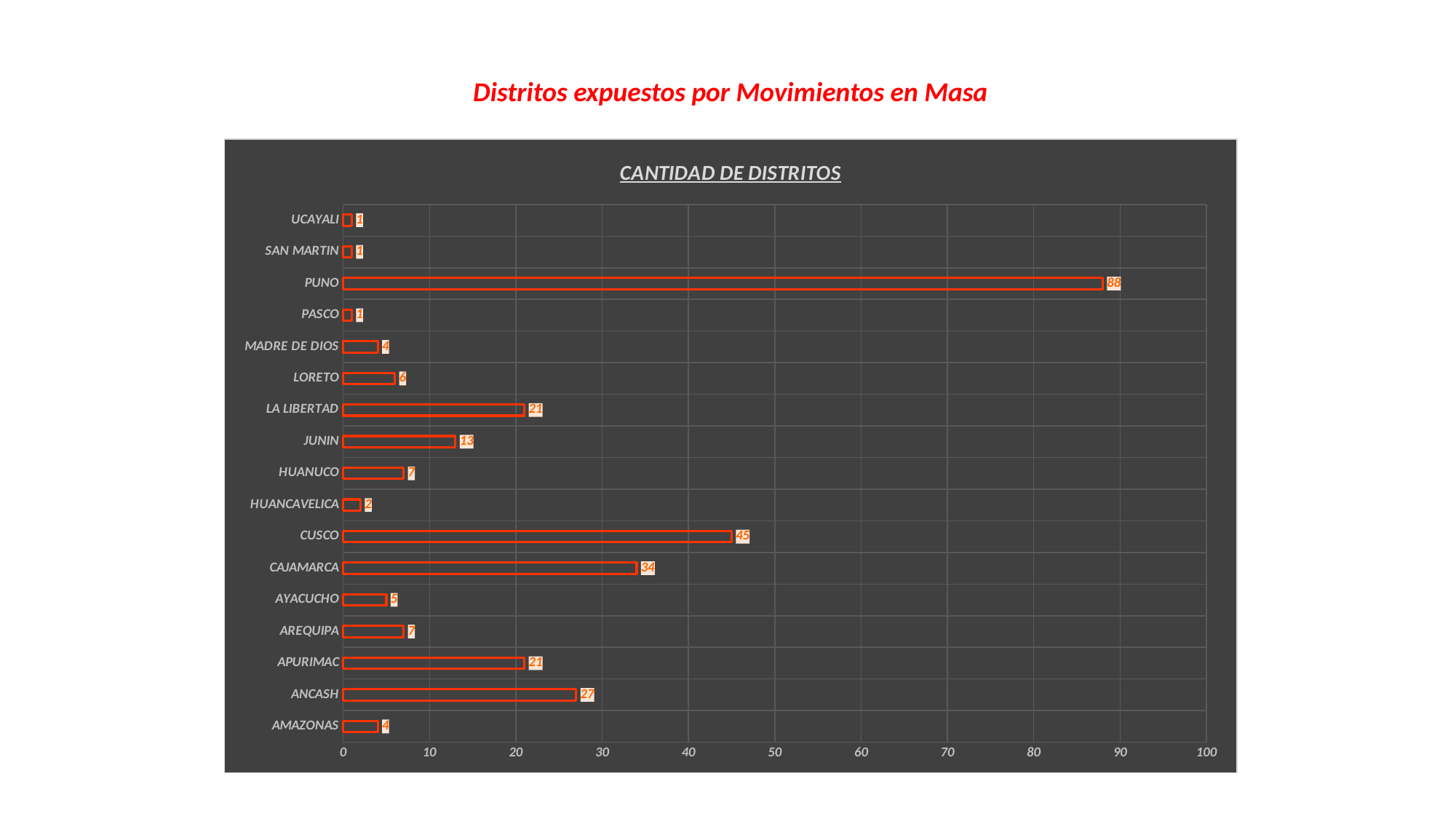
Which category has the highest value? PUNO What is the value for JUNIN? 13 What is the value for CAJAMARCA? 34 What is the smallest value shown on the chart? 1 Is the value for PUNO greater or less than 80? greater How many categories are shown on the chart? 17 What kind of chart is shown on the slide? bar chart What is the value for PUNO? 88 What is the value for CUSCO? 45 Which is larger, the value for CAJAMARCA or the value for ANCASH? CAJAMARCA What is the difference between the values for PUNO and CUSCO? 43 What is the difference between the values for ANCASH and APURIMAC? 6